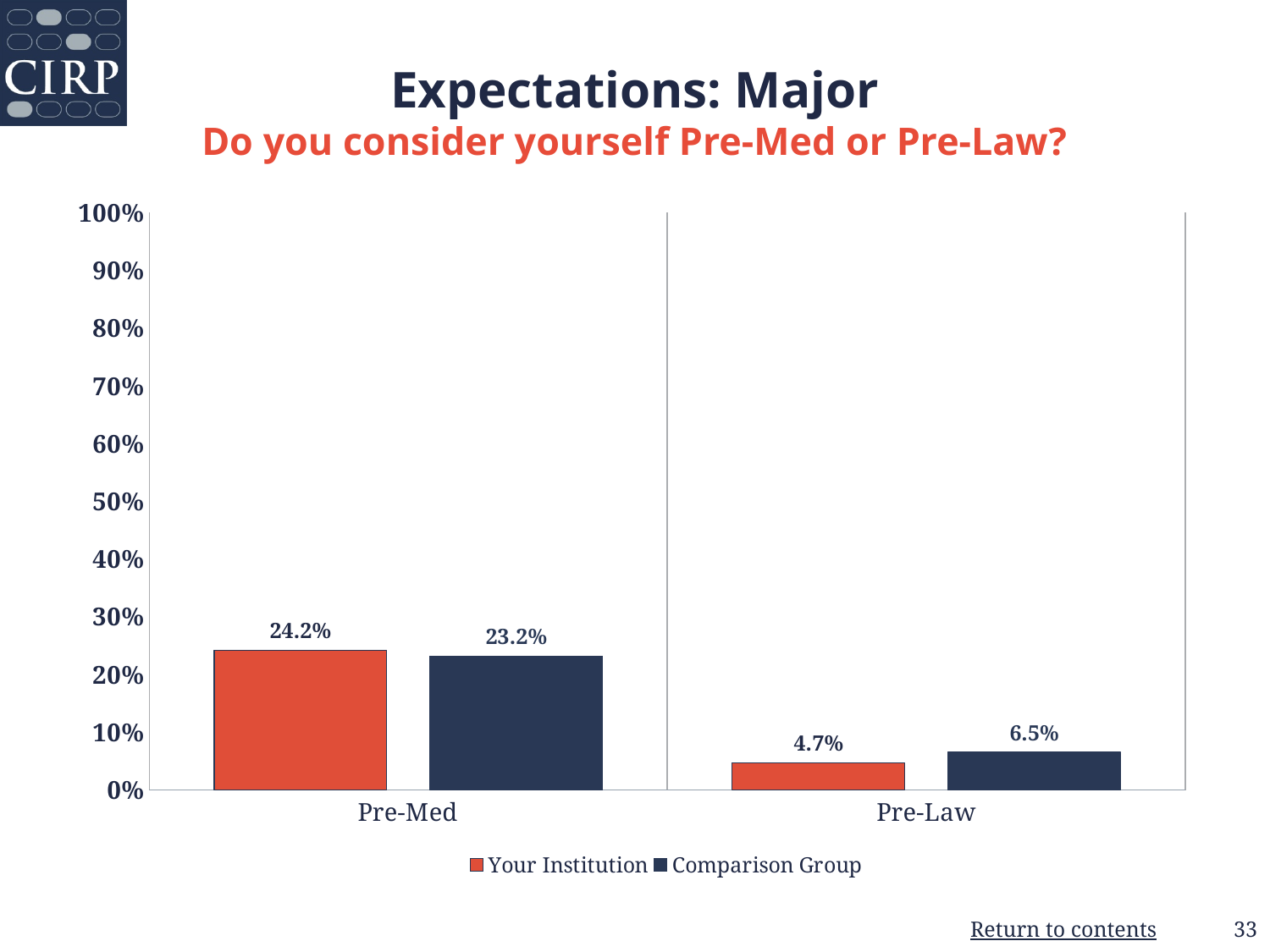
What is the difference between Your Institution and Comparison Group for Pre-Law? 1.8% What kind of chart is shown on the slide? Bar chart What is the difference between Your Institution and Comparison Group for Pre-Med? 1.0% What is the value for Your Institution for Pre-Law? 4.7% Which category has the lowest value for Comparison Group? Pre-Law Which category has the highest value for Your Institution? Pre-Med How many categories are shown on the x axis? 2 For Pre-Law, which is larger: Your Institution or Comparison Group? Comparison Group What is the value for Your Institution for Pre-Med? 24.2% What is the value for Comparison Group for Pre-Med? 23.2% How many series does the legend list? 2 What is the value for Comparison Group for Pre-Law? 6.5%